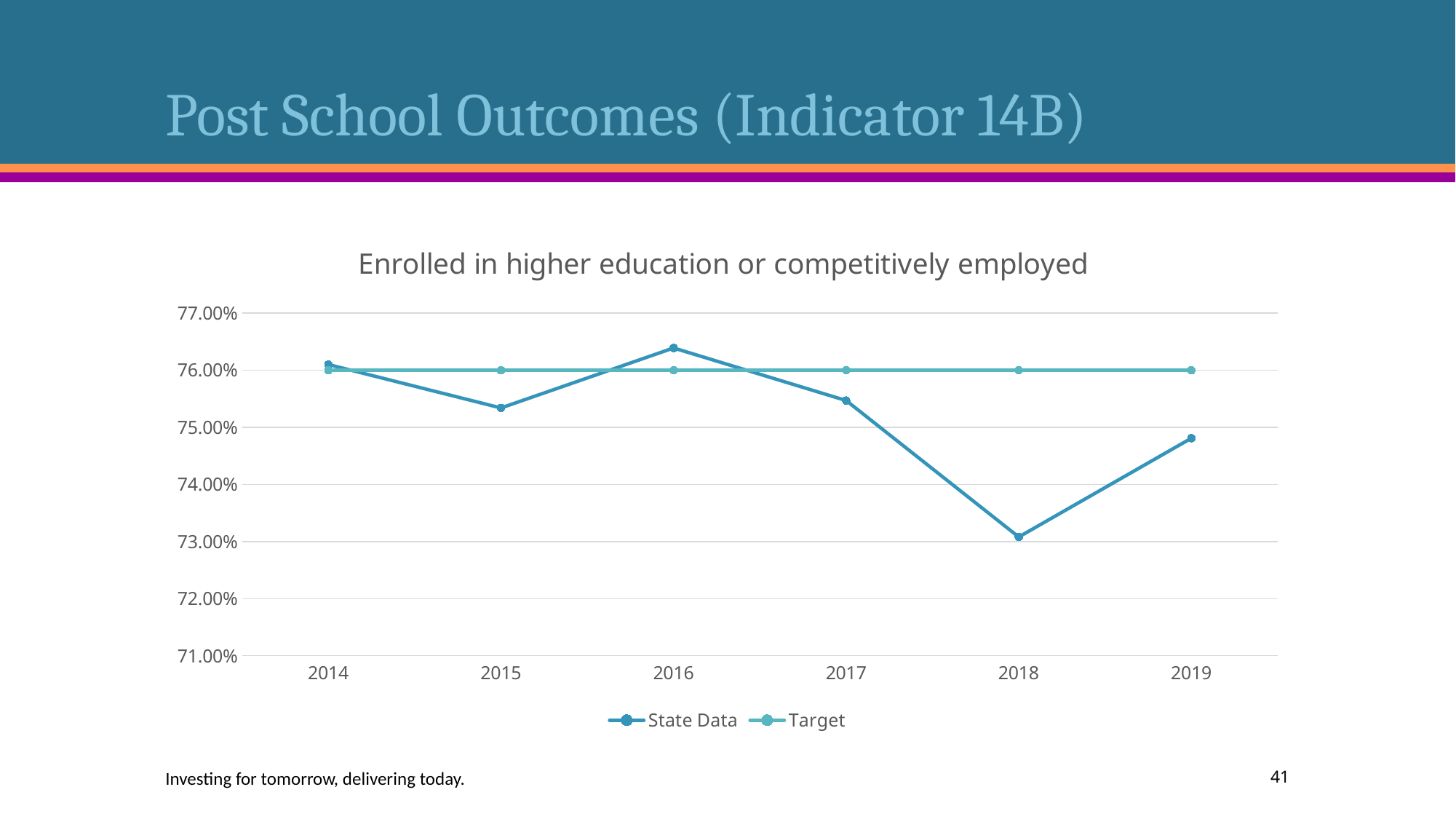
Is the State Data value for 2018 greater or less than 74.00%? less In which year is the State Data value highest? 2016 Is the State Data value for 2015 greater or less than 76.00%? less Does the State Data value rise or fall from 2017 to 2018? fall How many series does the legend list? 2 Is the State Data value for 2019 greater or less than 74.00%? greater What kind of chart is shown on the slide? line chart How many years are plotted along the x axis? 6 In which year is the State Data value lowest? 2018 Which is larger in 2016, State Data or Target? State Data What is the Target value in 2017? 76.00% What is the title of the chart? Enrolled in higher education or competitively employed